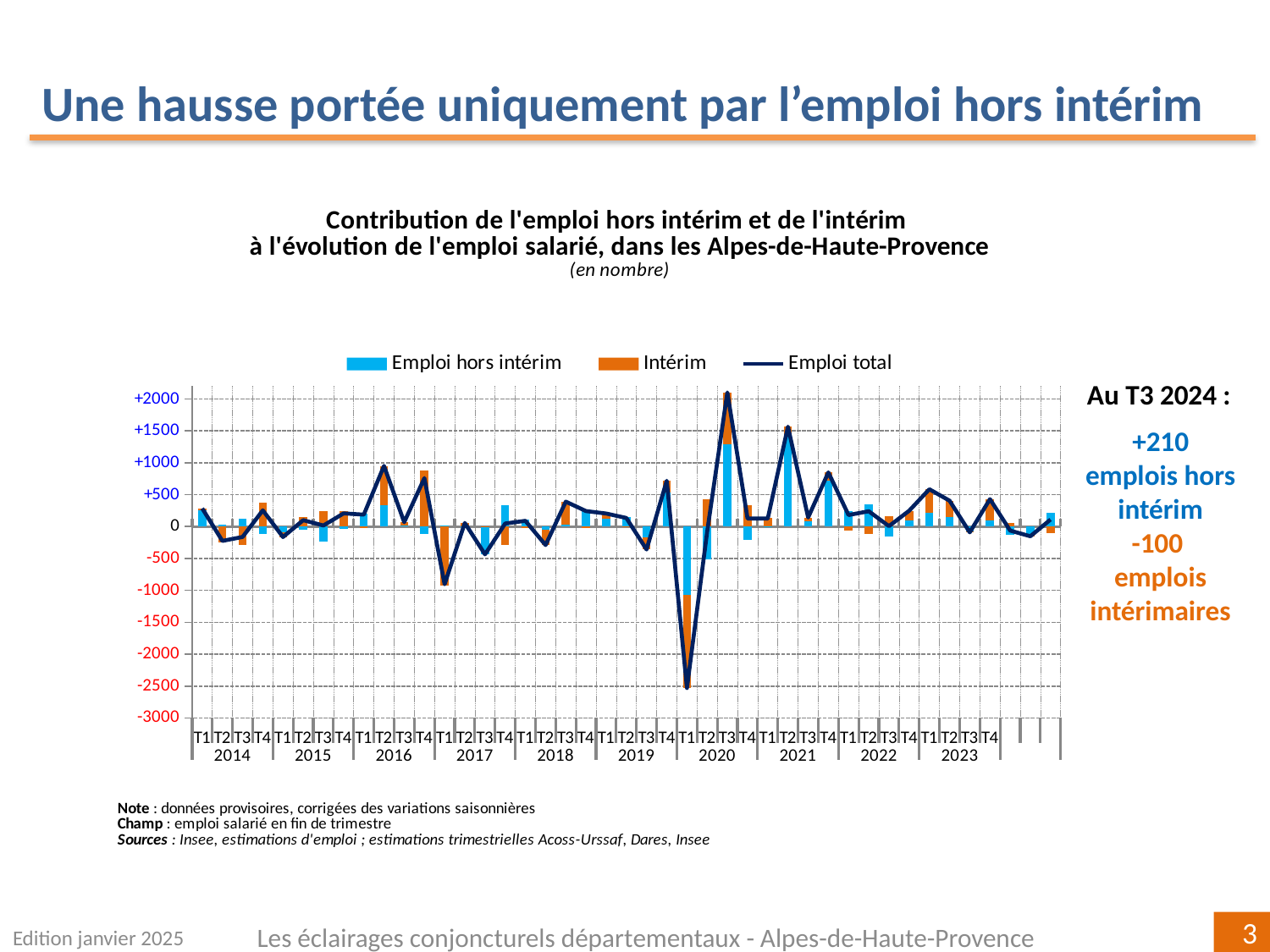
In which quarter does the 'Emploi total' line reach its lowest point? T1 2020 According to the slide, what is the value for 'emplois intérimaires' at T3 2024? -100 According to the slide, what is the value for 'emplois hors intérim' at T3 2024? +210 Is the value of 'Emploi total' at T1 2020 greater or less than -2000? less In which quarter does the 'Emploi total' line reach its highest point? T3 2020 Which is larger, the 'Emploi total' value at T3 2020 or at T2 2021? T3 2020 Is the value of 'Emploi total' at T3 2020 greater or less than +1500? greater What is the highest value shown on the vertical axis? +2000 What kind of chart is shown on the slide? A combined bar and line chart Which series is drawn as a line rather than bars? Emploi total How many series does the chart legend list? 3 Is the value of 'Emploi total' at T1 2017 greater or less than -500? less